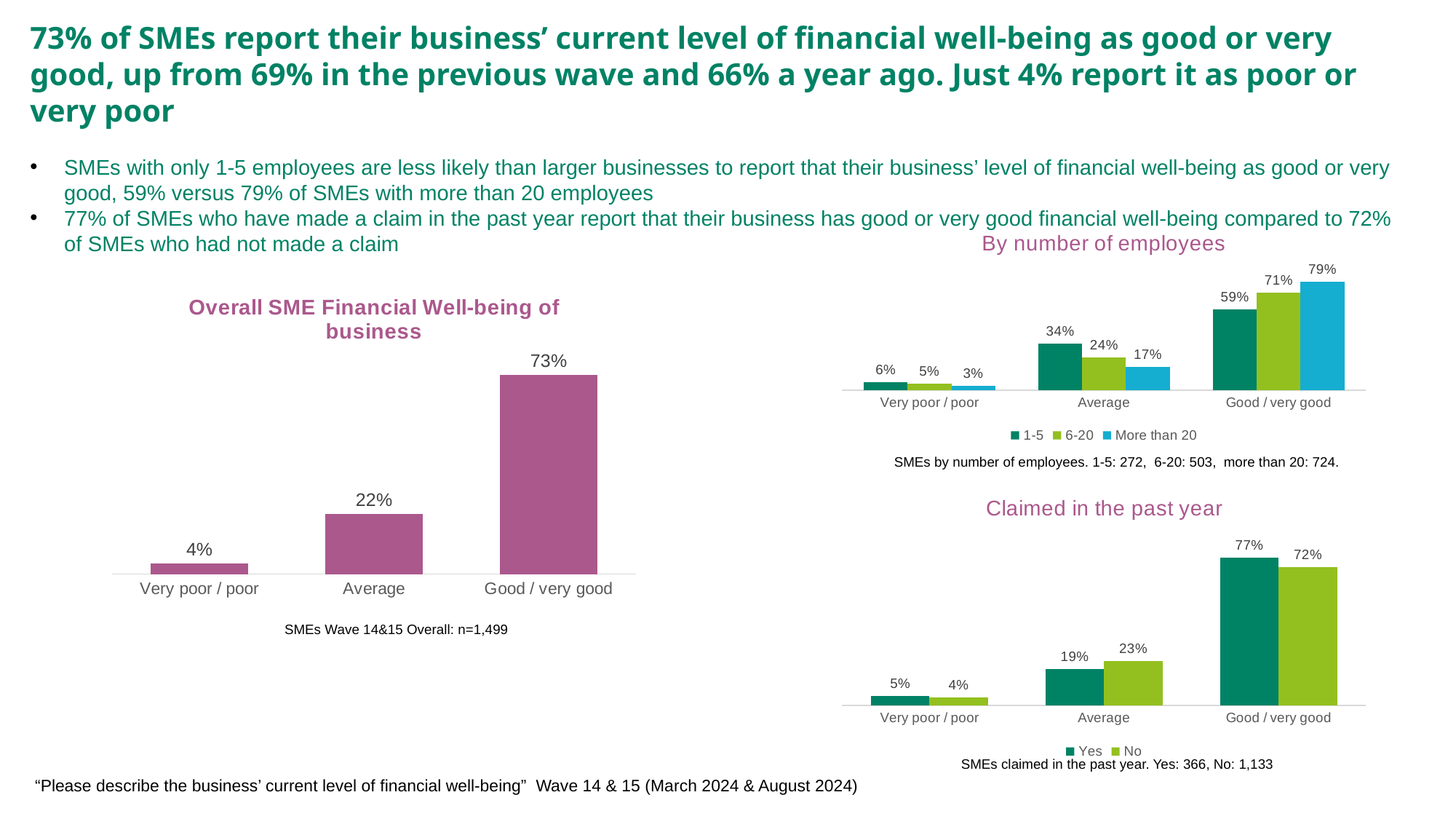
In the 'By number of employees' chart, what is the difference between the 1-5 and More than 20 values for Very poor / poor? 3% In the 'By number of employees' chart, what is the value for More than 20 in the Good / very good category? 79% In the 'Overall SME Financial Well-being of business' chart, what is the value for Good / very good? 73% In the 'Overall SME Financial Well-being of business' chart, what is the difference between Good / very good and Average? 51% How many series does the legend of the 'By number of employees' chart list? 3 In the 'By number of employees' chart, which series has the highest value in the Good / very good category? More than 20 How many categories are shown on the x axis of the 'Claimed in the past year' chart? 3 In the 'Claimed in the past year' chart, what is the value for No in the Average category? 23% What kind of chart is the 'Overall SME Financial Well-being of business' chart? Bar chart In the 'Claimed in the past year' chart, which is larger for Good / very good, Yes or No? Yes In the 'By number of employees' chart, what is the value for the 1-5 series in the Average category? 34% In the 'Overall SME Financial Well-being of business' chart, which category has the lowest value? Very poor / poor